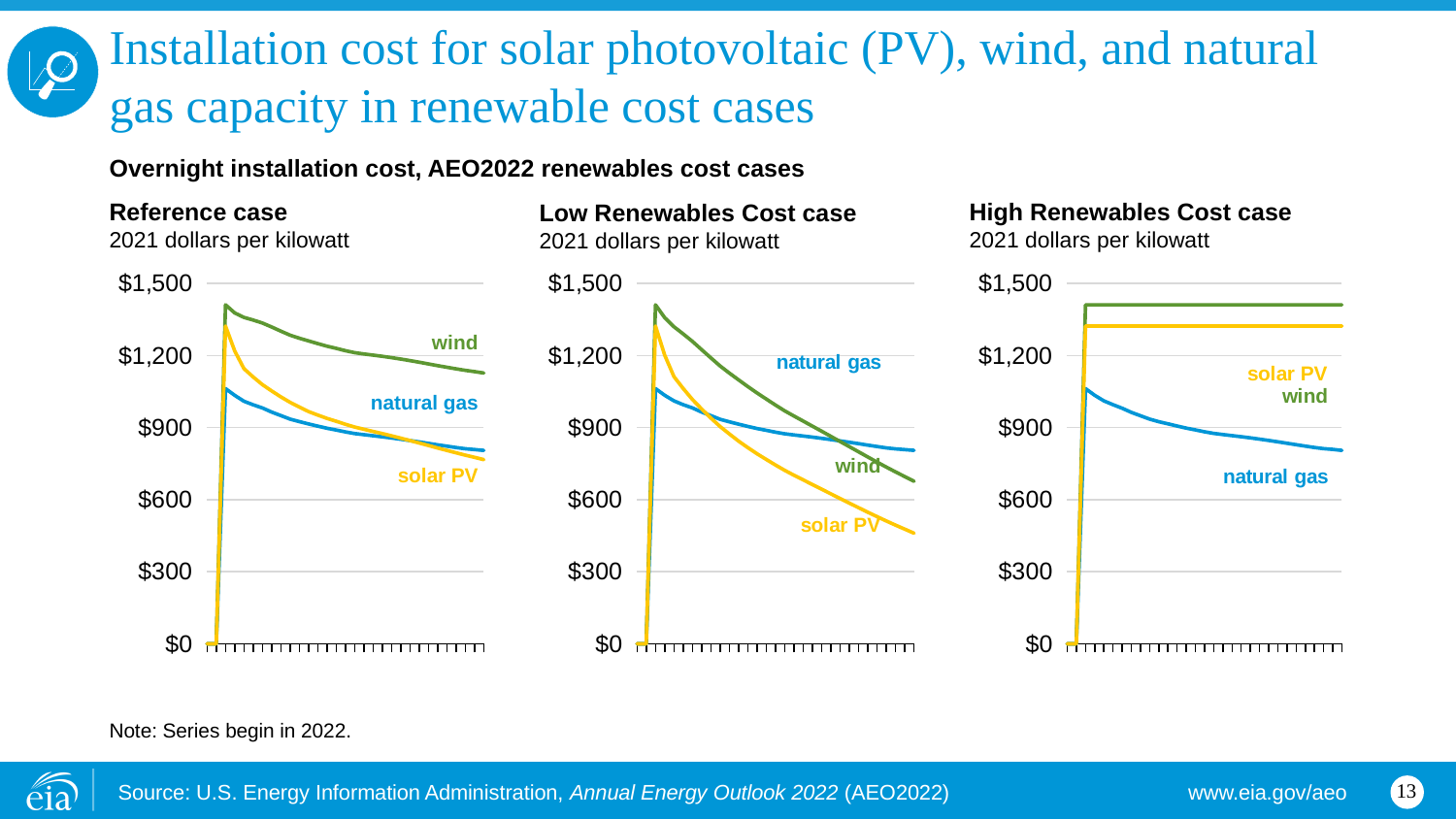
In the Low Renewables Cost case chart, is the final value for solar PV greater or less than $600? less In the High Renewables Cost case chart, is the value for wind greater or less than $1,200? greater In the Low Renewables Cost case chart, which series ends higher: natural gas or solar PV? natural gas In the High Renewables Cost case chart, is the final value for natural gas greater or less than $900? less In the Low Renewables Cost case chart, does the wind series rise or fall after its initial peak? fall In the High Renewables Cost case chart, does the solar PV series rise, fall, or stay flat after its initial jump? stay flat In the Reference case chart, which series ends higher: wind or natural gas? wind What kind of chart is the Reference case chart? line chart What unit is shown under the title of each chart? 2021 dollars per kilowatt How many series are plotted in the Low Renewables Cost case chart? 3